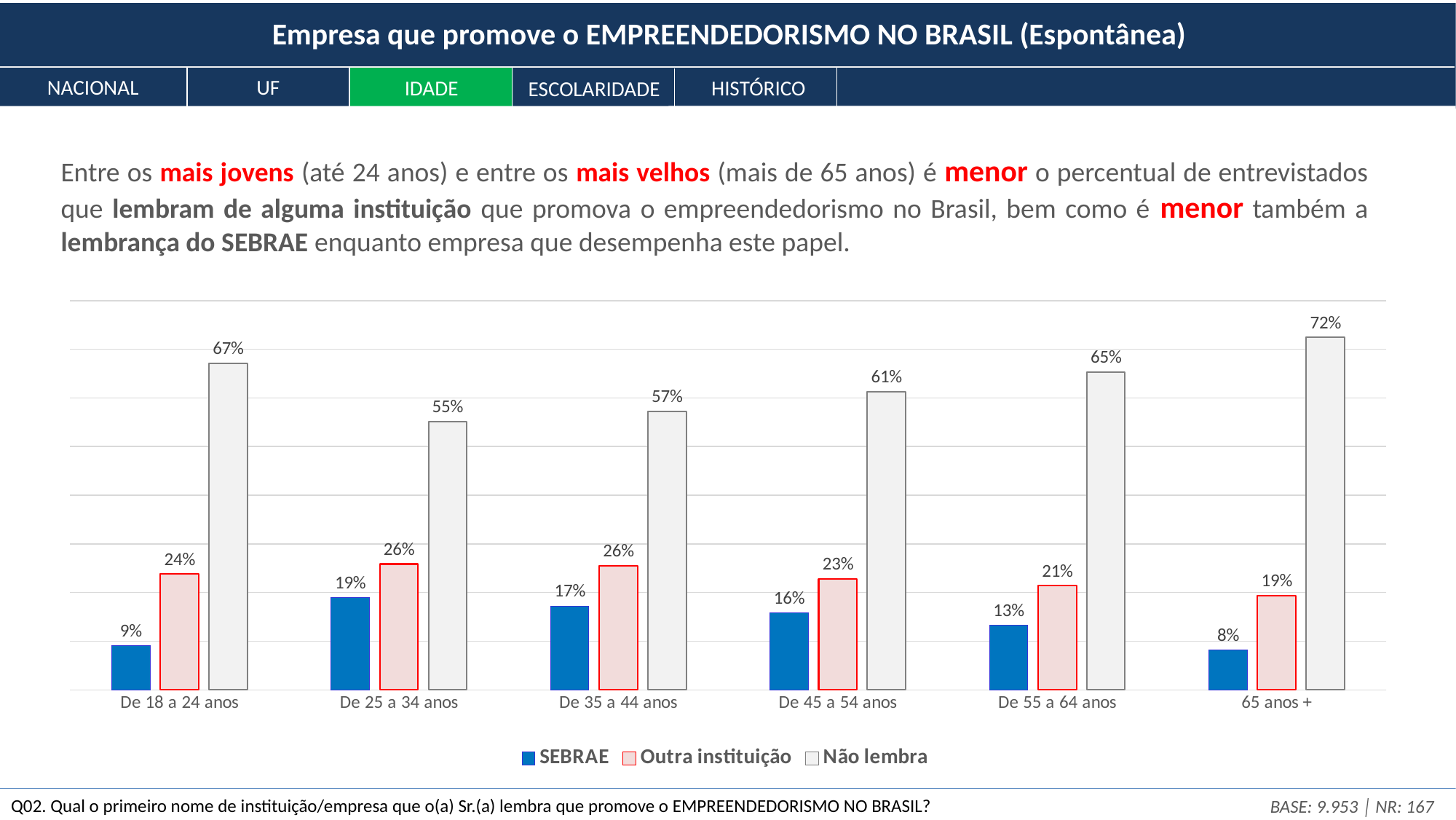
How many series does the legend list? 3 Which age group has the highest SEBRAE value? De 25 a 34 anos Which age group has the lowest 'Não lembra' value? De 25 a 34 anos Which series is shown in blue in the legend? SEBRAE Which is larger: the SEBRAE value for 'De 35 a 44 anos' or for 'De 55 a 64 anos'? De 35 a 44 anos What kind of chart is shown on the slide? Bar chart What is the 'Não lembra' value for the '65 anos +' age group? 72% Does the SEBRAE value rise or fall from 'De 25 a 34 anos' to '65 anos +'? Fall What is the 'Outra instituição' value for the 'De 45 a 54 anos' age group? 23% What is the difference between the 'Não lembra' values for '65 anos +' and 'De 18 a 24 anos'? 5% What is the SEBRAE value for the 'De 18 a 24 anos' age group? 9% How many age groups are shown on the x axis? 6